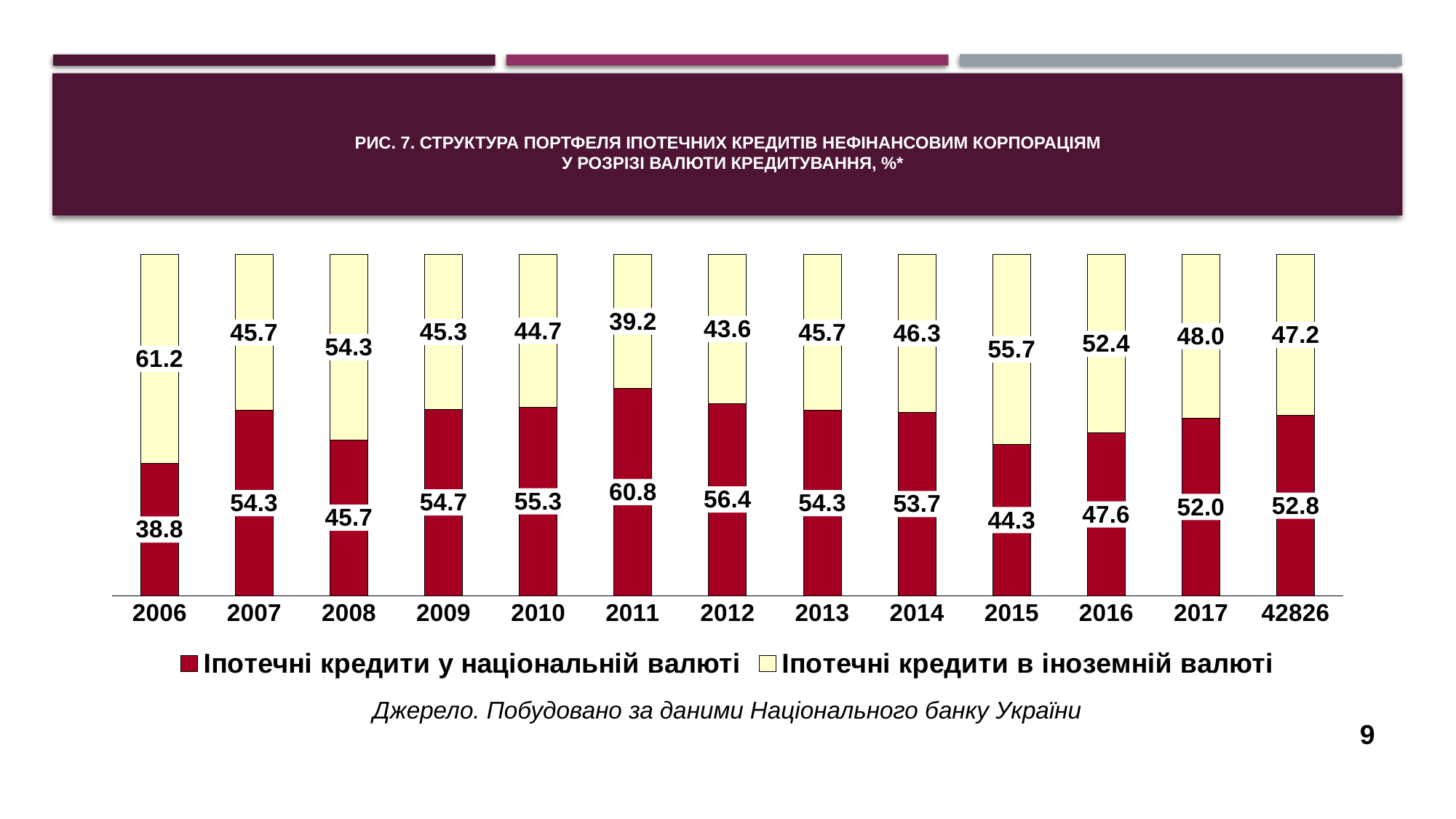
In 2015, which is larger: mortgage loans in national currency or in foreign currency? Іпотечні кредити в іноземній валюті (foreign currency) What kind of chart is shown on the slide? Stacked bar chart How many series does the legend list? 2 In which year is the share of mortgage loans in national currency the lowest? 2006 What is the value for mortgage loans in foreign currency (Іпотечні кредити в іноземній валюті) in 2006? 61.2 What is the value for mortgage loans in national currency in 2015? 44.3 In which year is the share of mortgage loans in foreign currency the lowest? 2011 How many years (categories) are shown on the x axis? 13 Does the share of mortgage loans in national currency rise or fall from 2006 to 2011? Rise In which year is the share of mortgage loans in national currency the highest? 2011 What is the difference between the national currency value and the foreign currency value in 2011? 21.6 What is the value for mortgage loans in national currency (Іпотечні кредити у національній валюті) in 2011? 60.8